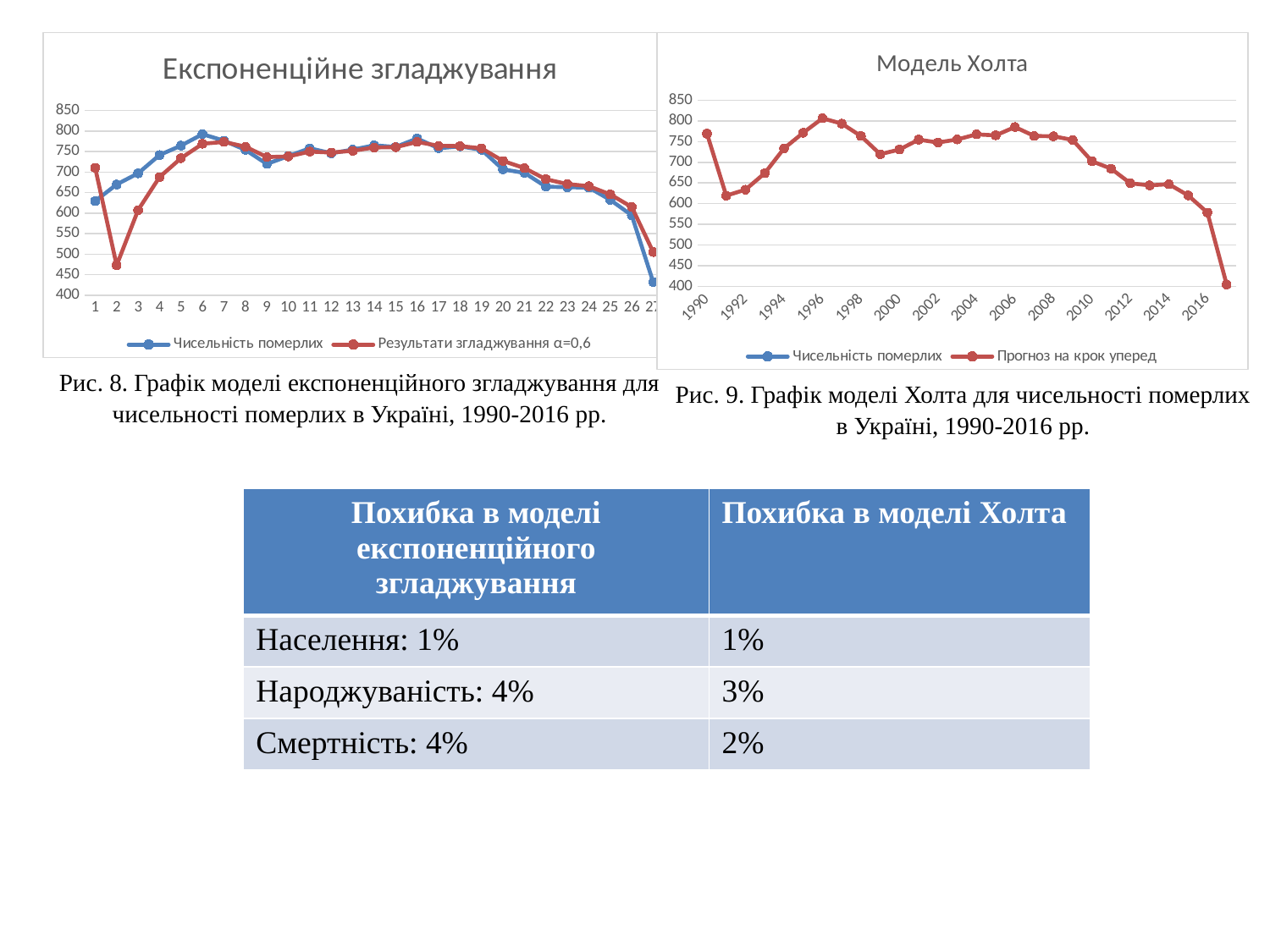
In the chart titled "Експоненційне згладжування", is the value of "Чисельність померлих" at point 27 greater or less than 450? less How many series does the legend of the chart titled "Експоненційне згладжування" list? 2 What kind of chart is the chart titled "Модель Холта"? line chart In the chart titled "Експоненційне згладжування", what is the name of the second series in the legend? Результати згладжування α=0,6 In the chart titled "Експоненційне згладжування", is the value of "Результати згладжування α=0,6" at point 2 greater or less than 500? less In the chart titled "Модель Холта", is the value for 1996 greater or less than 750? greater How many points are on the x axis of the chart titled "Експоненційне згладжування"? 27 What is the title of the chart on the right side of the slide? Модель Холта How many series does the legend of the chart titled "Модель Холта" list? 2 What kind of chart is the chart titled "Експоненційне згладжування"? line chart In the chart titled "Модель Холта", do the values rise or fall from 2010 to 2016? fall